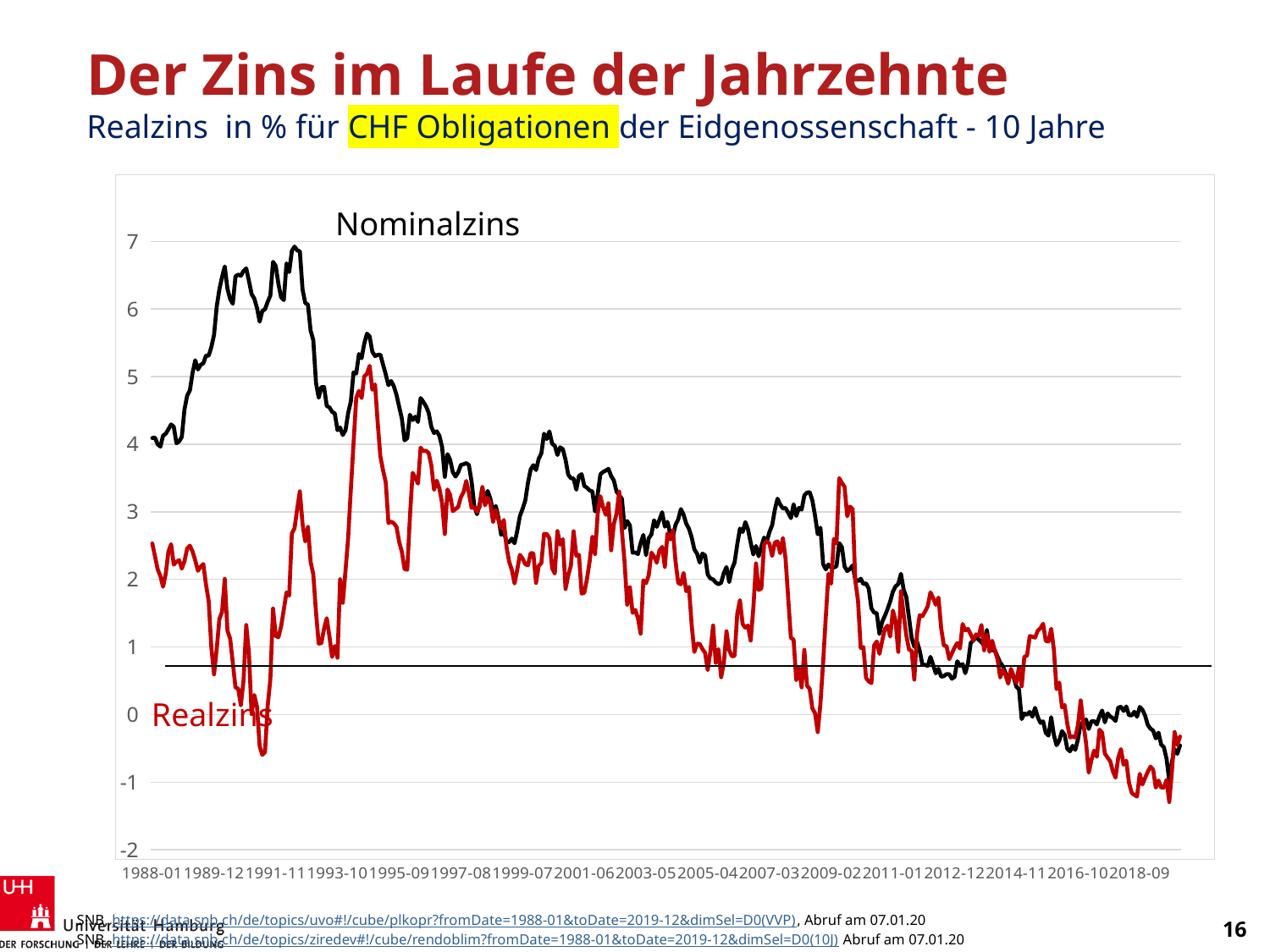
What colour is the Realzins line? red Is the highest value of the Nominalzins line greater or less than 6? greater Around 1989-12, which series has the higher value, Nominalzins or Realzins? Nominalzins What is the highest value shown on the vertical axis? 7 Is the Realzins value at the end of the series (2018-09) greater or less than 0? less What are the names of the two series plotted in the chart? Nominalzins and Realzins Over the whole period from 1988 to 2018, do the Realzins values generally rise or fall? fall Over the whole period from 1988 to 2018, do the Nominalzins values generally rise or fall? fall Is the Realzins value at the start of the series (1988-01) greater or less than 1? greater How many series are plotted in the chart? 2 What kind of chart is shown on the slide? line chart